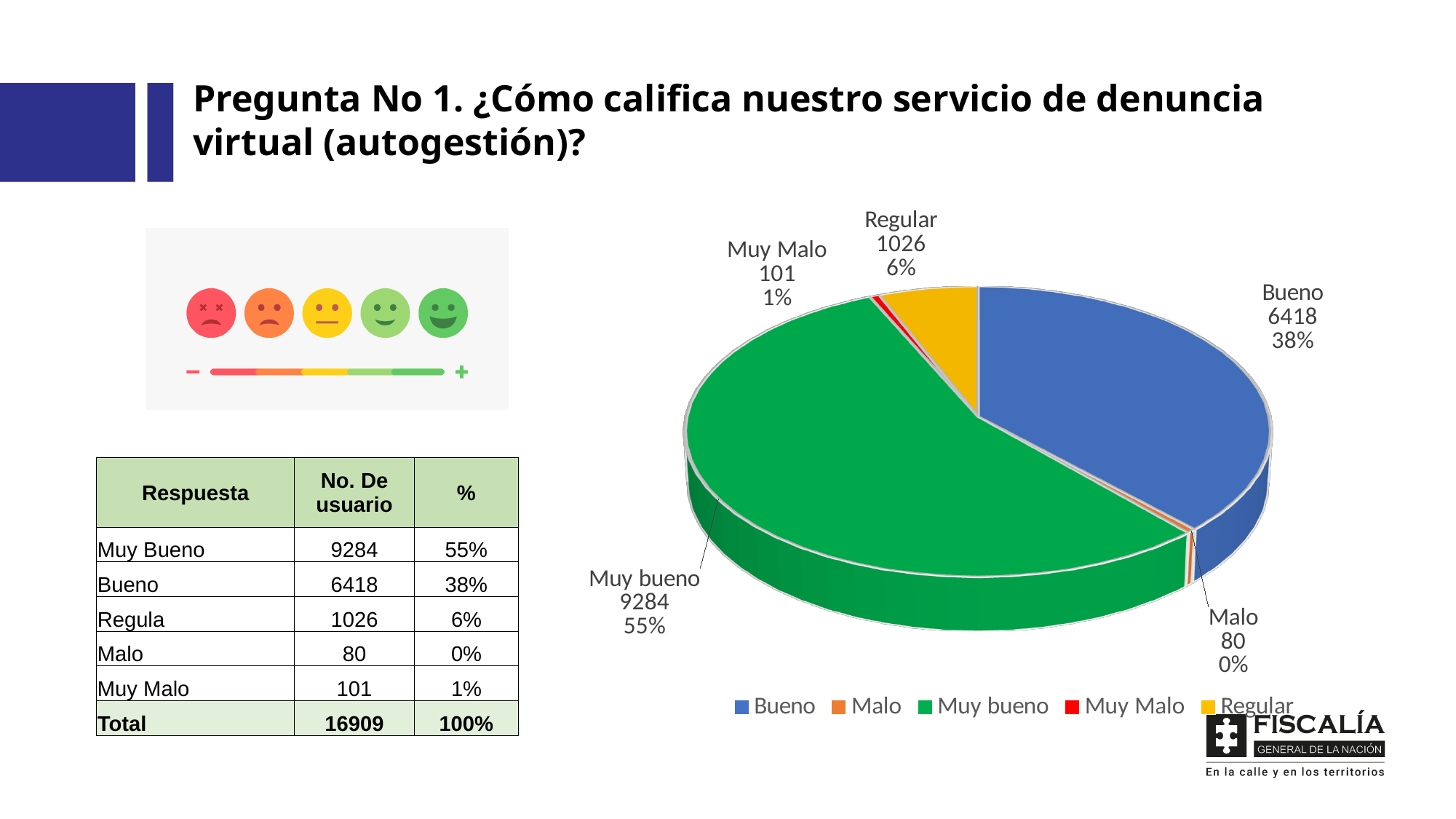
What is the difference in number of users between Muy bueno and Bueno in the pie chart? 2866 How many categories does the pie chart show? 5 What colour is the Muy bueno slice in the pie chart? Green Which is larger in the pie chart, Regular or Muy Malo? Regular How many entries does the legend of the pie chart list? 5 What kind of chart is shown on the slide? Pie chart Which category has the smallest slice in the pie chart? Malo What percentage share does the Regular slice have in the pie chart? 6% What is the value shown for Muy Malo in the pie chart? 101 How many users rated the service as Bueno according to the pie chart? 6418 What percentage share does the Malo slice have in the pie chart? 0% Which category has the largest slice in the pie chart? Muy bueno